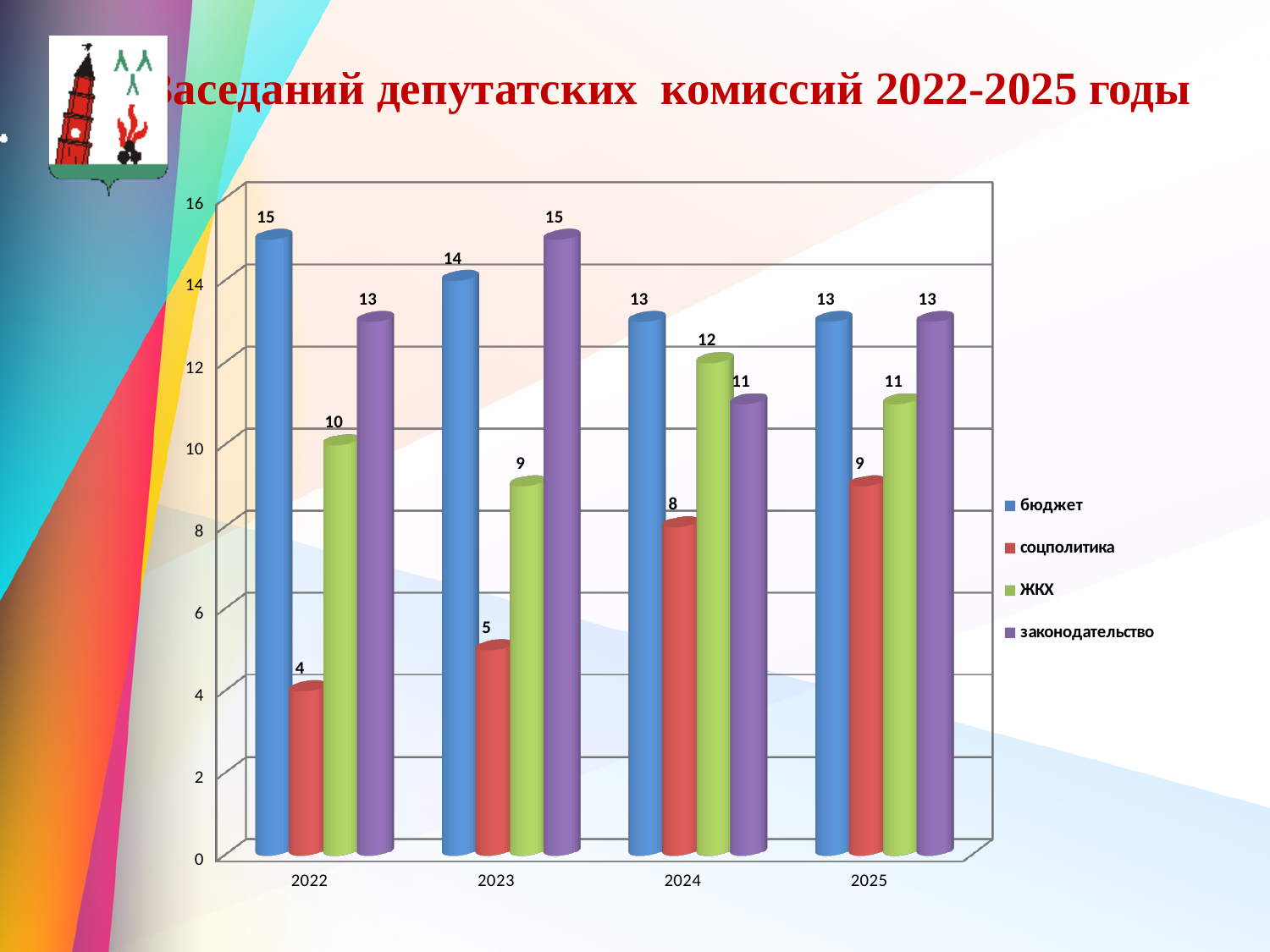
What kind of chart is shown on the slide? bar chart What is the value for бюджет in 2022? 15 What is the value for законодательство in 2025? 13 In which year is the value for соцполитика lowest? 2022 What is the value for соцполитика in 2023? 5 Does the value for соцполитика rise or fall from 2022 to 2025? rise What is the difference between бюджет and соцполитика in 2022? 11 How many years are shown on the x axis? 4 In which year is the value for законодательство highest? 2023 Which is larger in 2024: ЖКХ or законодательство? ЖКХ How many series does the legend list? 4 What is the value for ЖКХ in 2024? 12